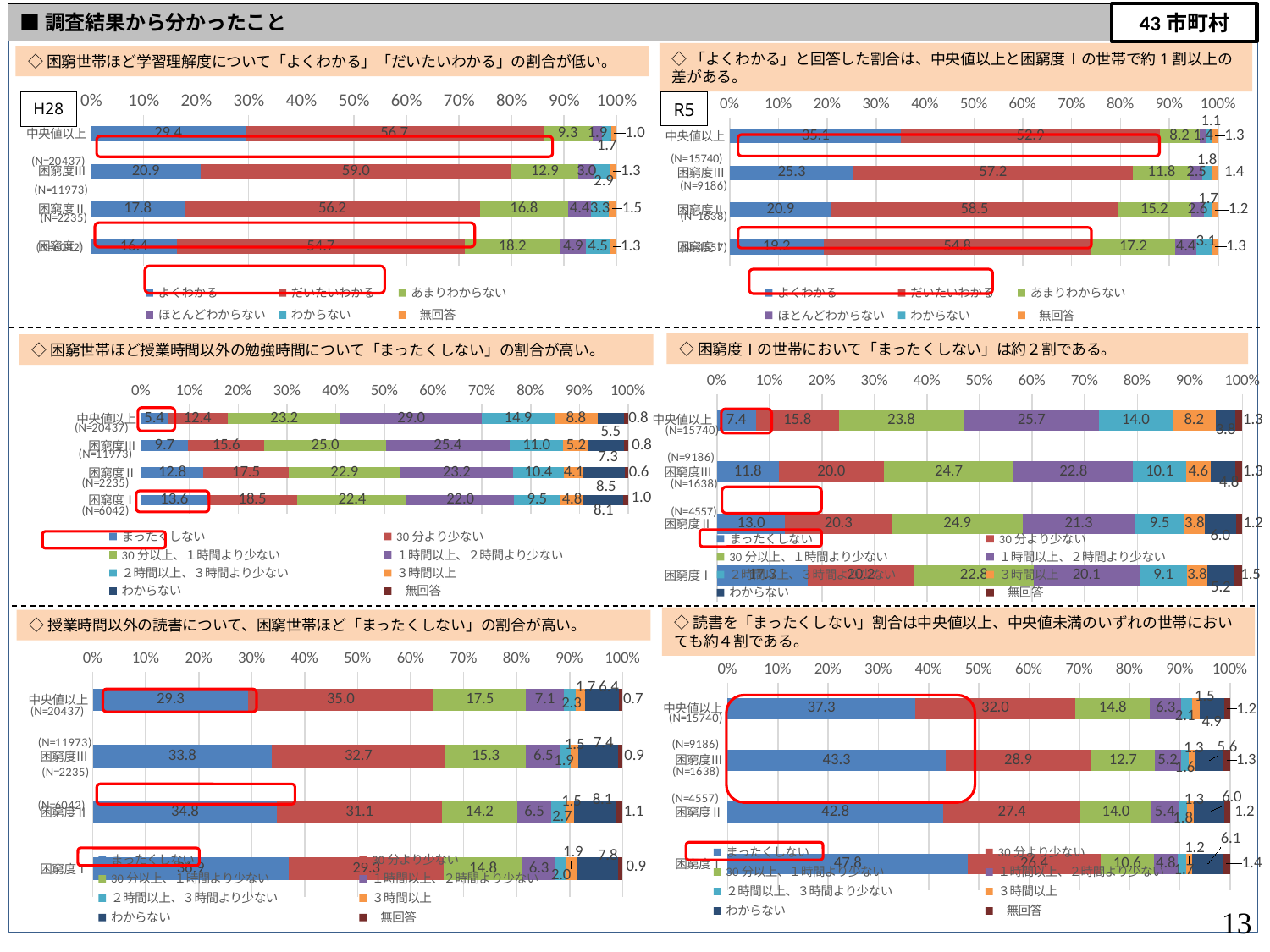
In the top-right chart (R5, 学習理解度), what is the difference between the よくわかる values for 中央値以上 and 困窮度Ⅰ? 15.9 What type of chart is the top-left chart (H28, 学習理解度)? Stacked bar chart In the top-left chart (H28, 学習理解度), which category has the highest value for あまりわからない? 困窮度Ⅰ How many series does the legend of the middle-left chart (H28, 勉強時間) list? 8 In the middle-left chart (H28, 勉強時間), what is the value of まったくしない for 困窮度Ⅰ? 13.6 In the top-left chart (H28, 学習理解度), what is the value of よくわかる for 中央値以上? 29.4 In the bottom-right chart (R5, 読書), which is larger, the まったくしない value for 困窮度Ⅲ or for 中央値以上? 困窮度Ⅲ In the middle-right chart (R5, 勉強時間), what is the value of 1時間以上、2時間より少ない for 中央値以上? 25.7 In the top-right chart (R5, 学習理解度), what is the value of よくわかる for 困窮度Ⅰ? 19.2 In the bottom-left chart (H28, 読書), what is the value of 30分より少ない for 中央値以上? 35.0 In the bottom-right chart (R5, 読書), what is the value of まったくしない for 困窮度Ⅰ? 47.8 In the middle-right chart (R5, 勉強時間), which category has the lowest value for まったくしない? 中央値以上